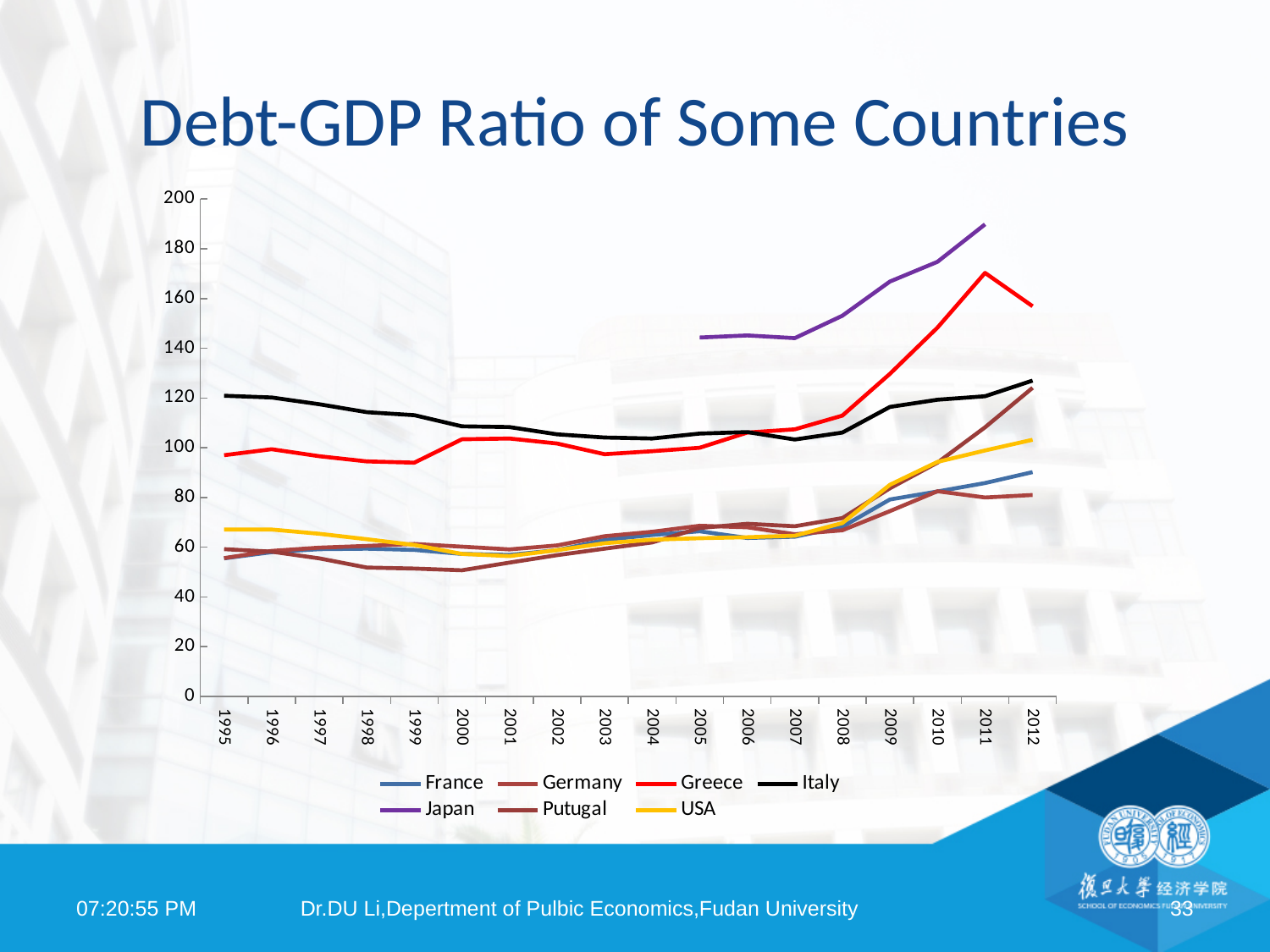
Which country has the highest debt-GDP ratio in 2012? Greece How many years are shown on the x axis? 18 What is the title of the chart? Debt-GDP Ratio of Some Countries Is the value for Italy in 1995 greater or less than 100? greater How many series does the legend list? 7 Is the value for USA in 1995 greater or less than 80? less Is the value for Greece in 2011 greater or less than 160? greater Which country has the highest debt-GDP ratio in 1995? Italy What kind of chart is shown on the slide? line chart Which is larger in 2012, the value for Greece or the value for Italy? Greece